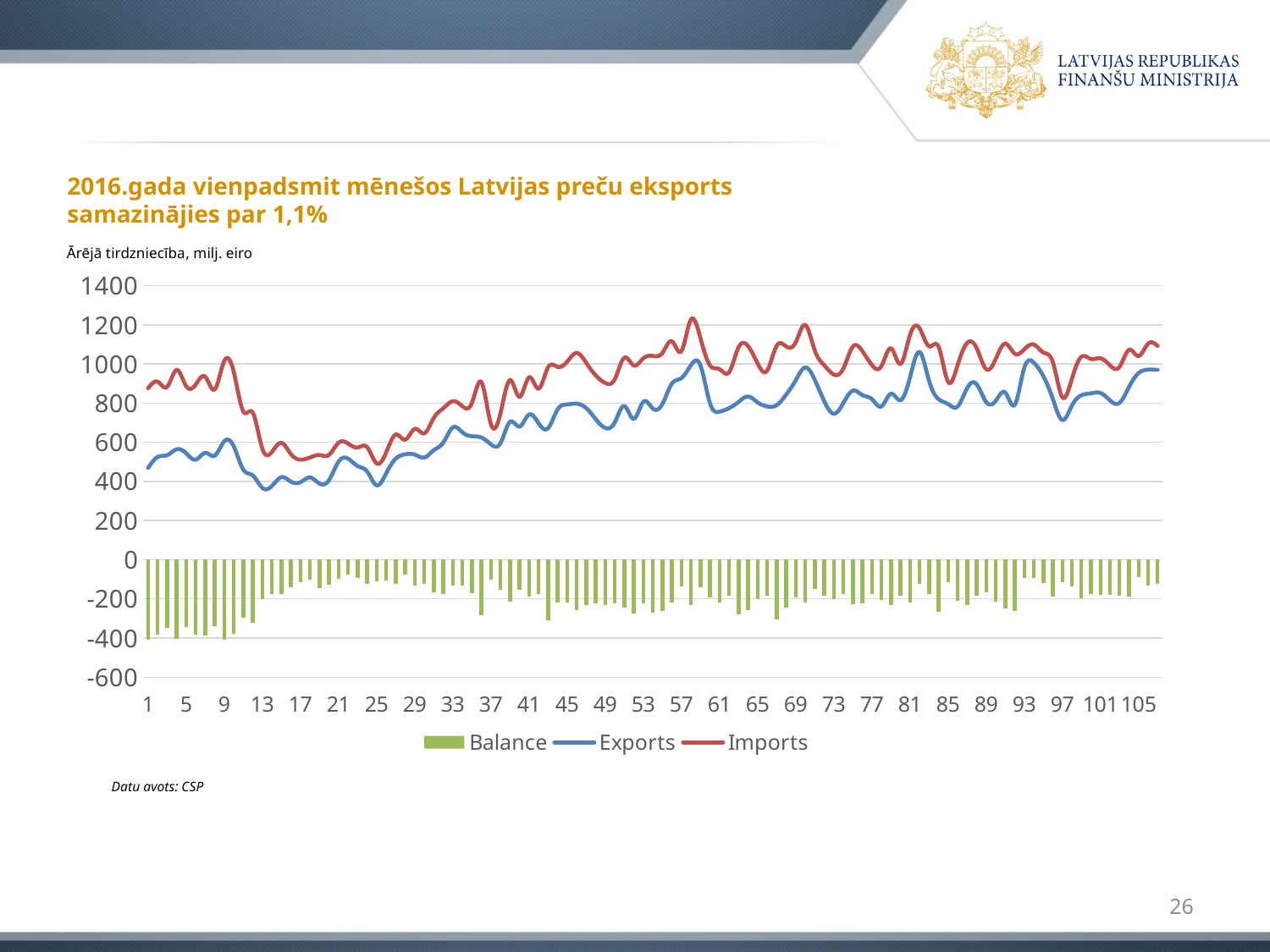
At point 57, which is larger, Exports or Imports? Imports Do the Exports values overall rise or fall from point 1 to point 105? rise Is the Imports value at point 105 greater or less than 800? greater How many series does the legend list? 3 What kind of chart is shown on the slide? A combined bar and line chart Is the Balance value at point 1 greater or less than -200? less Which series is drawn with the red line? Imports Are the Balance bars positive or negative across the chart? negative Is the Exports value at point 25 greater or less than 600? less Which series is drawn as bars? Balance